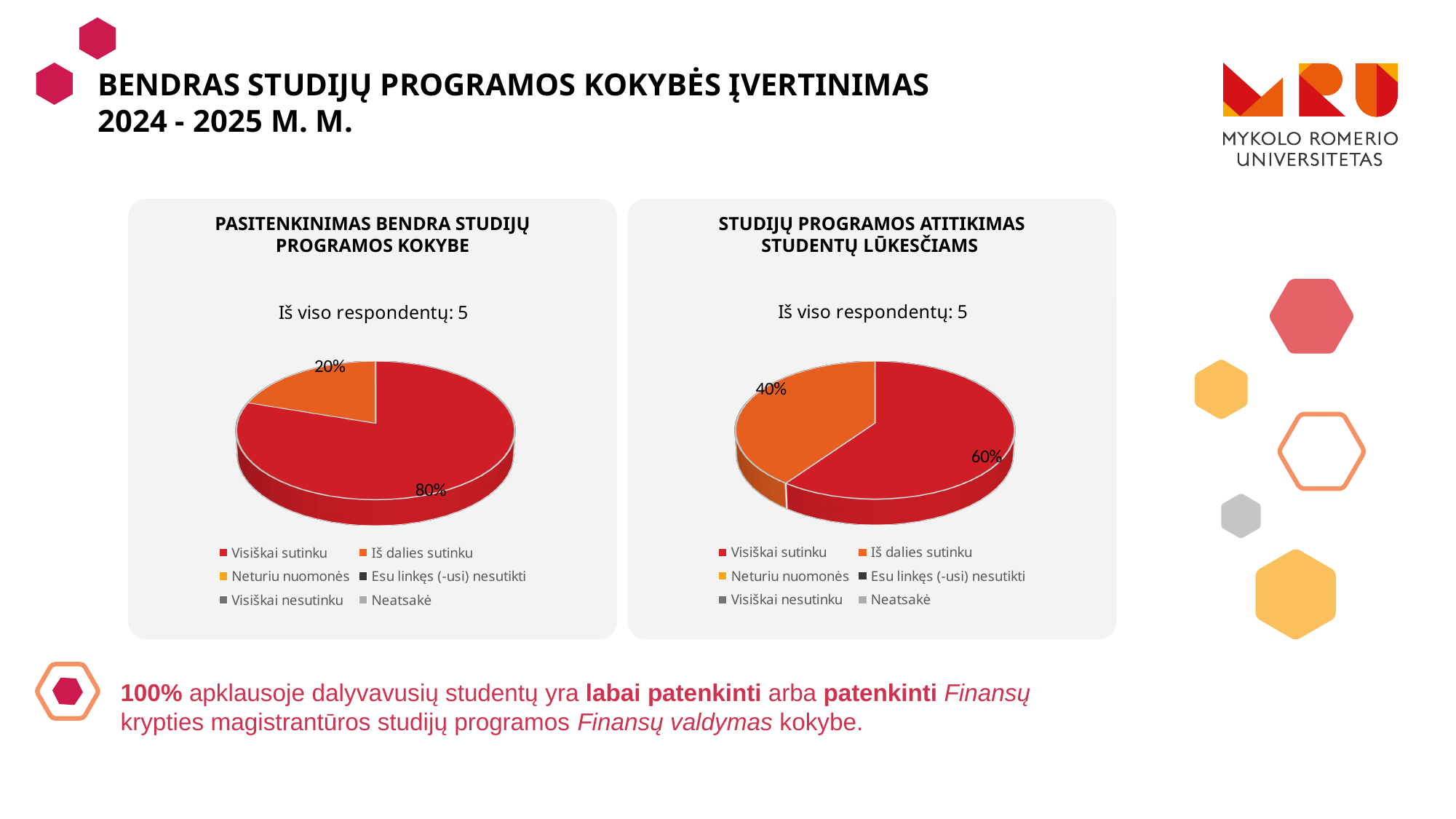
How many entries does the legend of the left chart list? 6 In the left chart, what is the difference between the 'Visiškai sutinku' and 'Iš dalies sutinku' shares? 60% What type of chart is used in the chart titled 'STUDIJŲ PROGRAMOS ATITIKIMAS STUDENTŲ LŪKESČIAMS'? Pie chart In the chart titled 'STUDIJŲ PROGRAMOS ATITIKIMAS STUDENTŲ LŪKESČIAMS', what share of the pie is 'Iš dalies sutinku'? 40% Is the 'Visiškai sutinku' share larger in the left chart or in the right chart? Left chart In the chart titled 'PASITENKINIMAS BENDRA STUDIJŲ PROGRAMOS KOKYBE', what share of the pie is 'Visiškai sutinku'? 80% In the right chart, what is the difference between the 'Visiškai sutinku' and 'Iš dalies sutinku' shares? 20% According to the left chart, how many respondents were there in total? 5 In the right chart, which category has the smallest slice? Iš dalies sutinku In the chart titled 'STUDIJŲ PROGRAMOS ATITIKIMAS STUDENTŲ LŪKESČIAMS', what share of the pie is 'Visiškai sutinku'? 60% In the left chart, which category has the largest slice? Visiškai sutinku